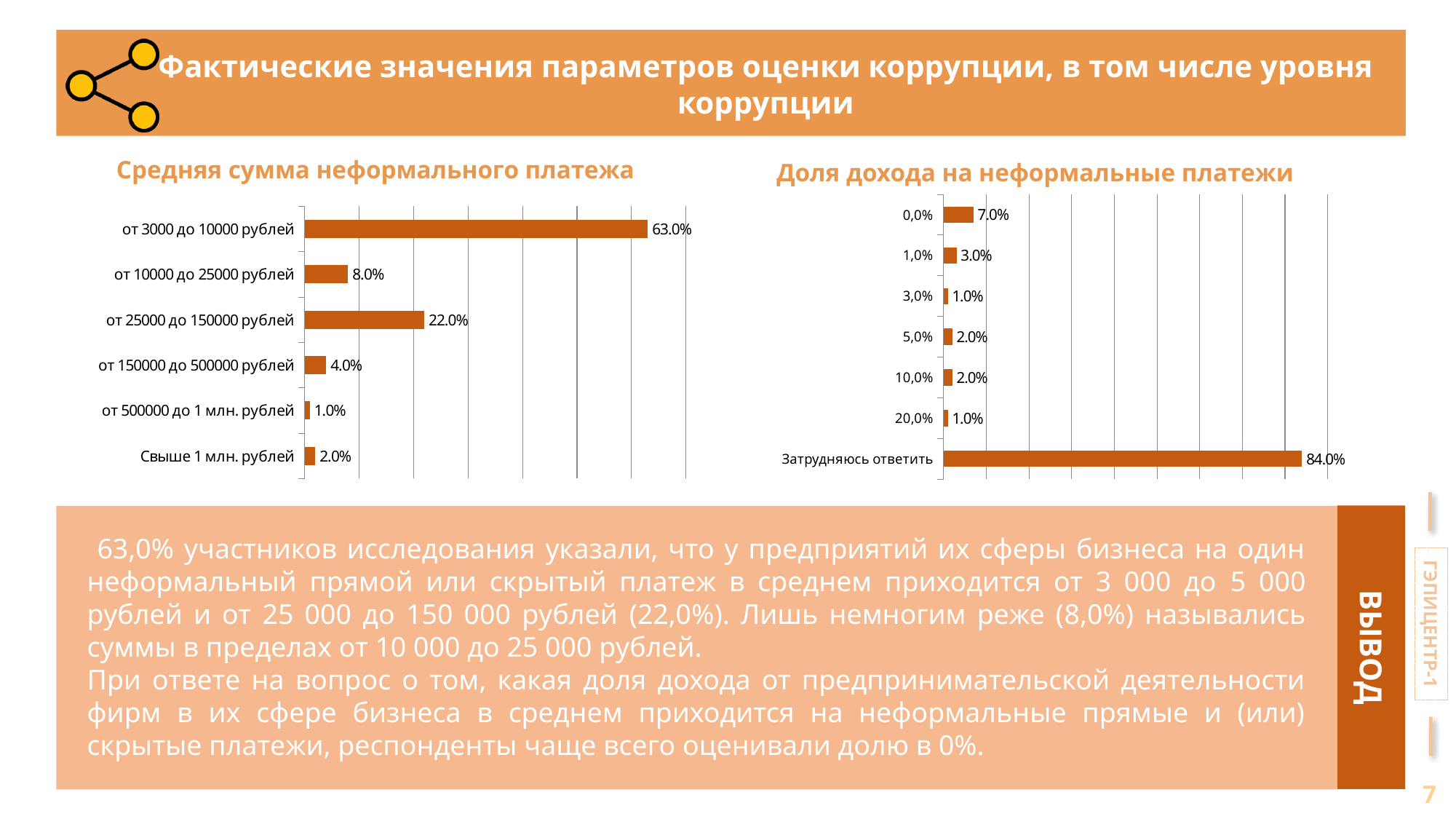
In the chart 'Доля дохода на неформальные платежи', which is larger: the value for '1,0%' or the value for '5,0%'? 1,0% In the chart 'Средняя сумма неформального платежа', which category has the lowest value? от 500000 до 1 млн. рублей In the chart 'Доля дохода на неформальные платежи', what is the value for 'Затрудняюсь ответить'? 84.0% In the chart 'Доля дохода на неформальные платежи', which category has the highest value? Затрудняюсь ответить What type of chart is 'Средняя сумма неформального платежа'? Bar chart In the chart 'Доля дохода на неформальные платежи', what is the value for '0,0%'? 7.0% In the chart 'Средняя сумма неформального платежа', what is the value for 'от 25000 до 150000 рублей'? 22.0% In the chart 'Средняя сумма неформального платежа', what is the value for 'от 3000 до 10000 рублей'? 63.0% In the chart 'Средняя сумма неформального платежа', how many categories are shown? 6 In the chart 'Доля дохода на неформальные платежи', what is the difference between 'Затрудняюсь ответить' and '0,0%'? 77.0% In the chart 'Доля дохода на неформальные платежи', how many categories are shown? 7 In the chart 'Средняя сумма неформального платежа', what is the difference between 'от 25000 до 150000 рублей' and 'от 10000 до 25000 рублей'? 14.0%